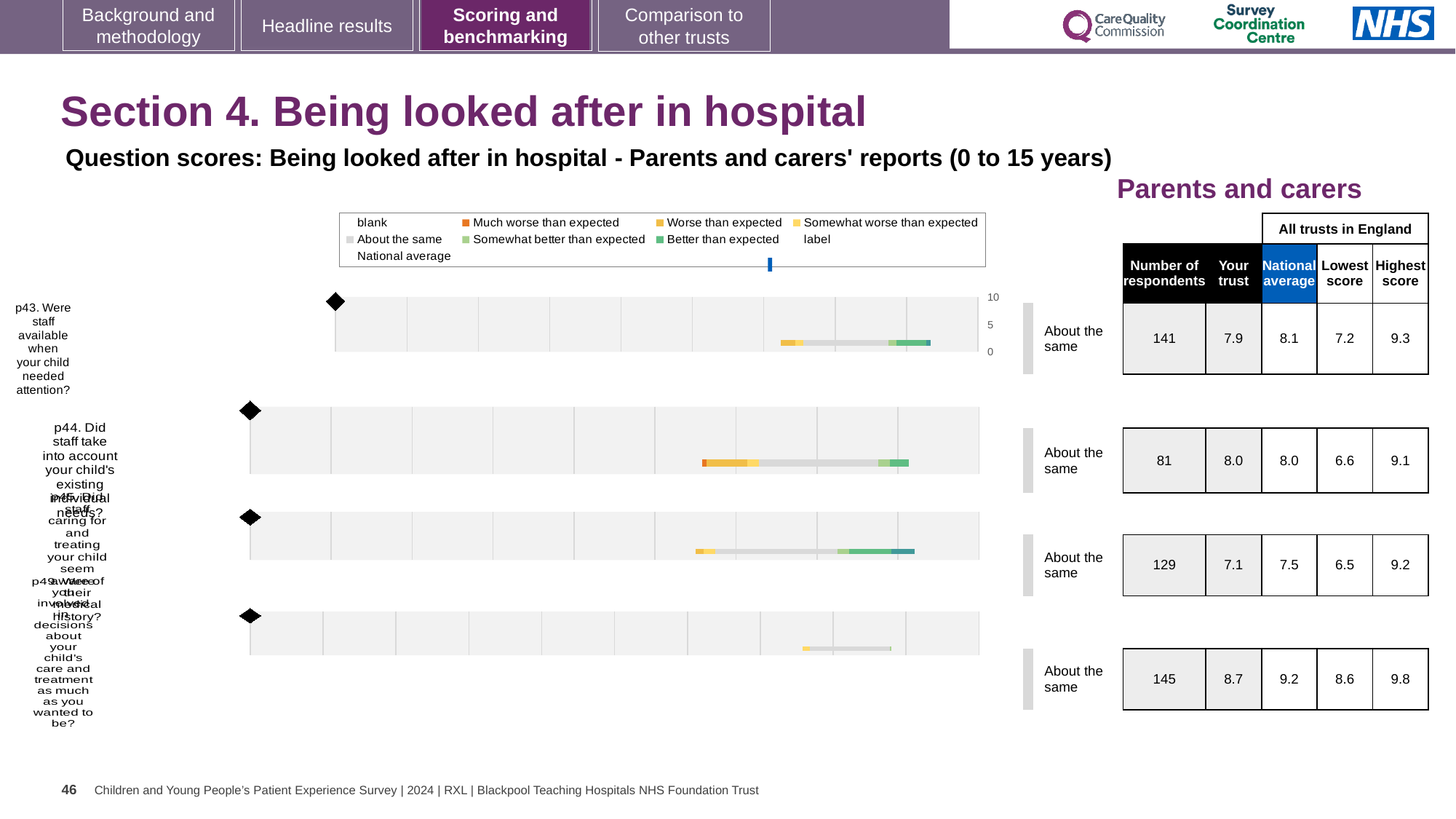
For p43 (Were staff available when your child needed attention?), how many respondents are there? 141 Which question on the slide has the lowest 'Your trust' score? p45 For p49 (Were you involved in decisions about your child's care and treatment as much as you wanted to be?), what is the highest score across all trusts in England? 9.8 What colour does the legend use for 'Better than expected'? green Which question on the slide has the highest 'Your trust' score? p49 How many question charts are shown on the slide? 4 What is the title shown above the charts? Question scores: Being looked after in hospital - Parents and carers' reports (0 to 15 years) For p43, which is larger: the 'Your trust' score or the national average? National average For p43, what is the difference between the highest score and the lowest score across all trusts in England? 2.1 For p43 (Were staff available when your child needed attention?), what is the 'Your trust' score? 7.9 What kind of chart is used for the question scores on this slide? bar chart For p44 (Did staff take into account your child's existing individual needs?), what is the national average score? 8.0